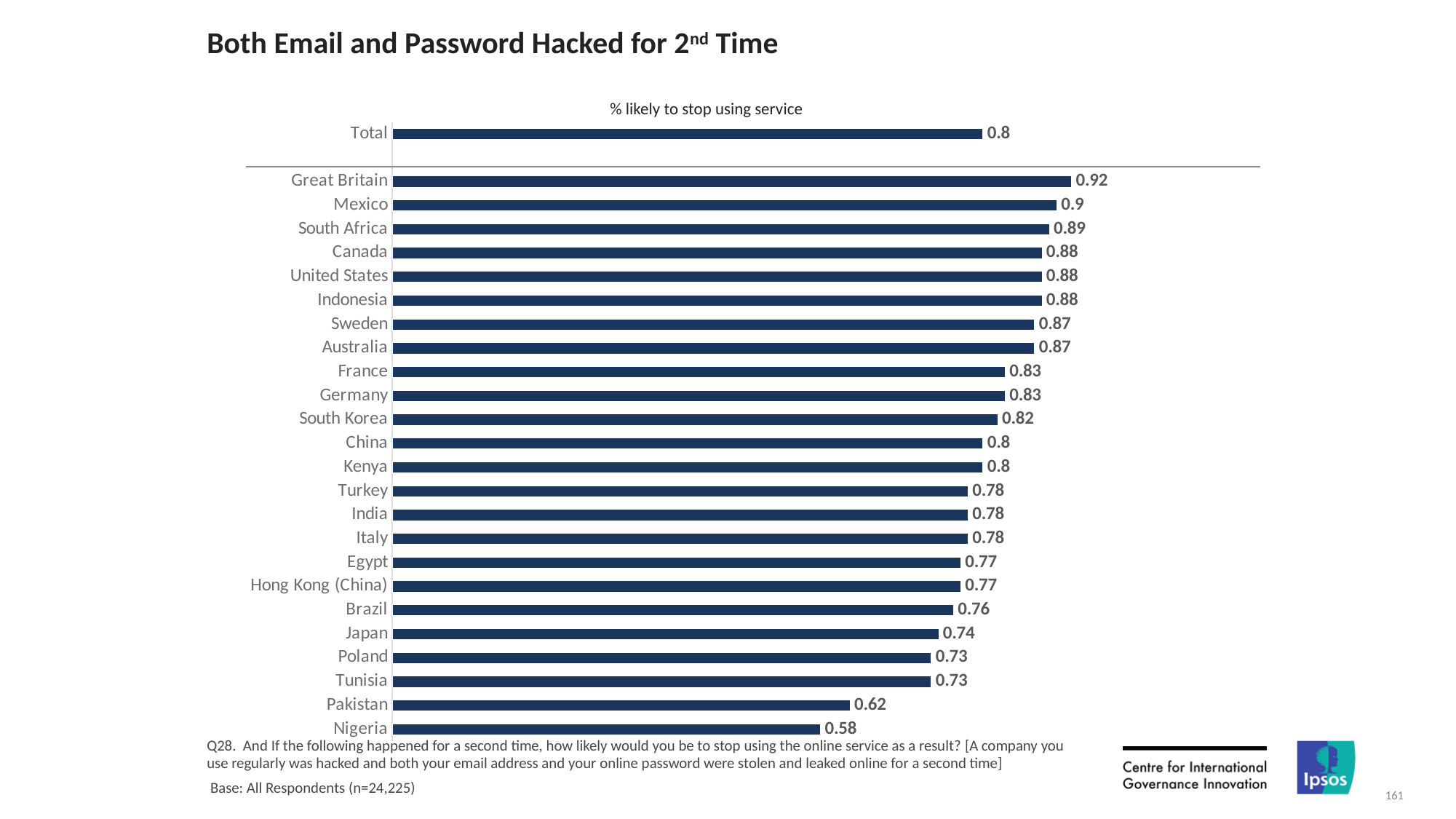
What is the value for Nigeria? 0.58 What is the difference between the values for Mexico and Pakistan? 0.28 What is the title shown above the chart's bars? % likely to stop using service What is the difference between the values for Great Britain and Nigeria? 0.34 What is the value for Total? 0.8 Which country has the lowest value? Nigeria What is the value for Great Britain? 0.92 What is the value for Japan? 0.74 Which country has the highest value? Great Britain How many countries (excluding Total) are shown in the chart? 24 What kind of chart is shown on the slide? Bar chart Which is larger, the value for France or the value for Brazil? France